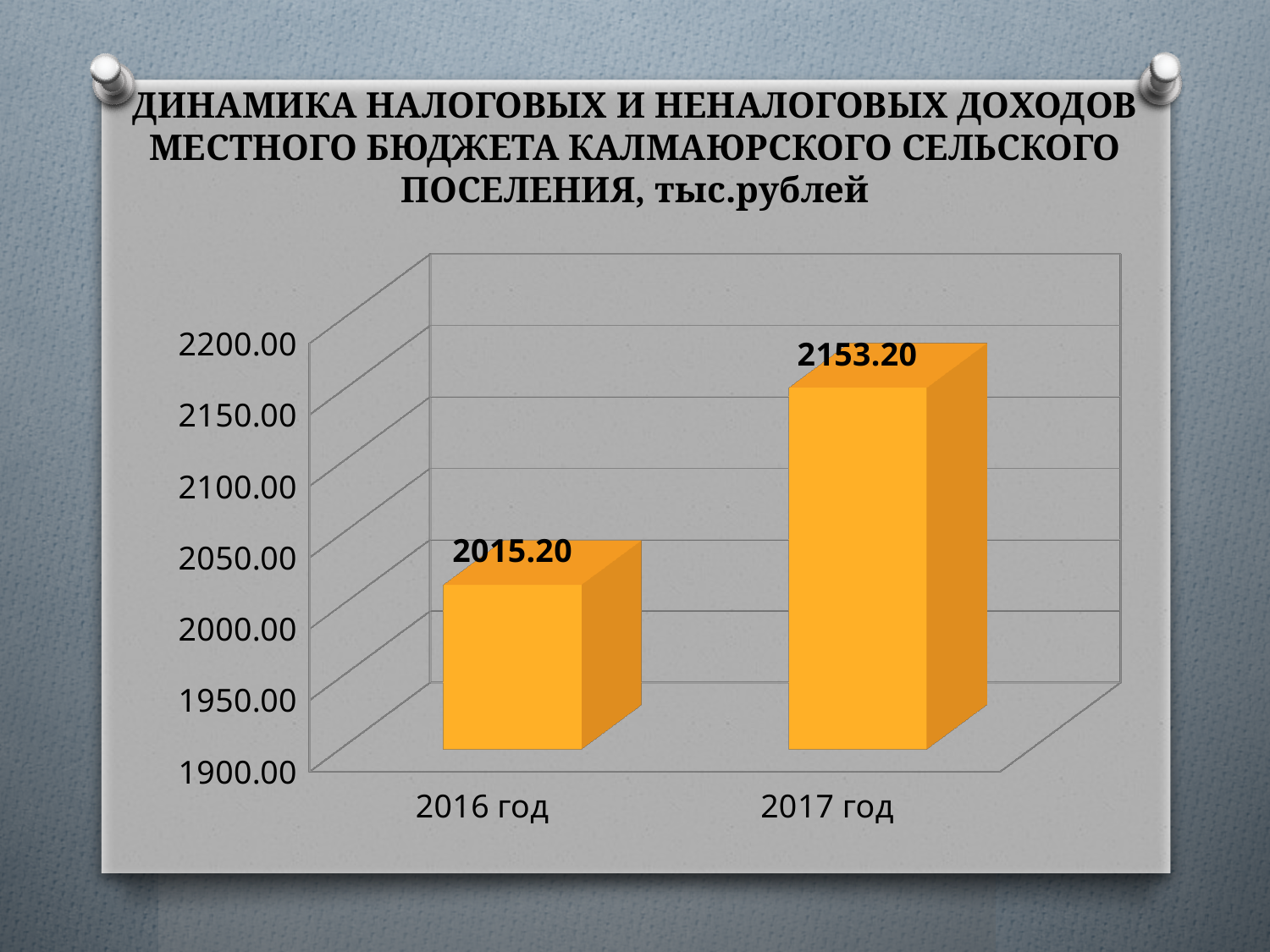
What kind of chart is shown on the slide? bar chart What is the value for 2017 год? 2153.20 Is the value for 2017 год greater or less than 2100.00? greater What is the value for 2016 год? 2015.20 Which is larger, the value for 2016 год or the value for 2017 год? 2017 год How many categories are shown on the x axis? 2 What unit of measurement is stated in the chart title? тыс.рублей Do the values rise or fall from 2016 год to 2017 год? rise Is the value for 2016 год greater or less than 2050.00? less Which year has the lowest value? 2016 год What is the difference between the values for 2017 год and 2016 год? 138.00 Which year has the highest value? 2017 год